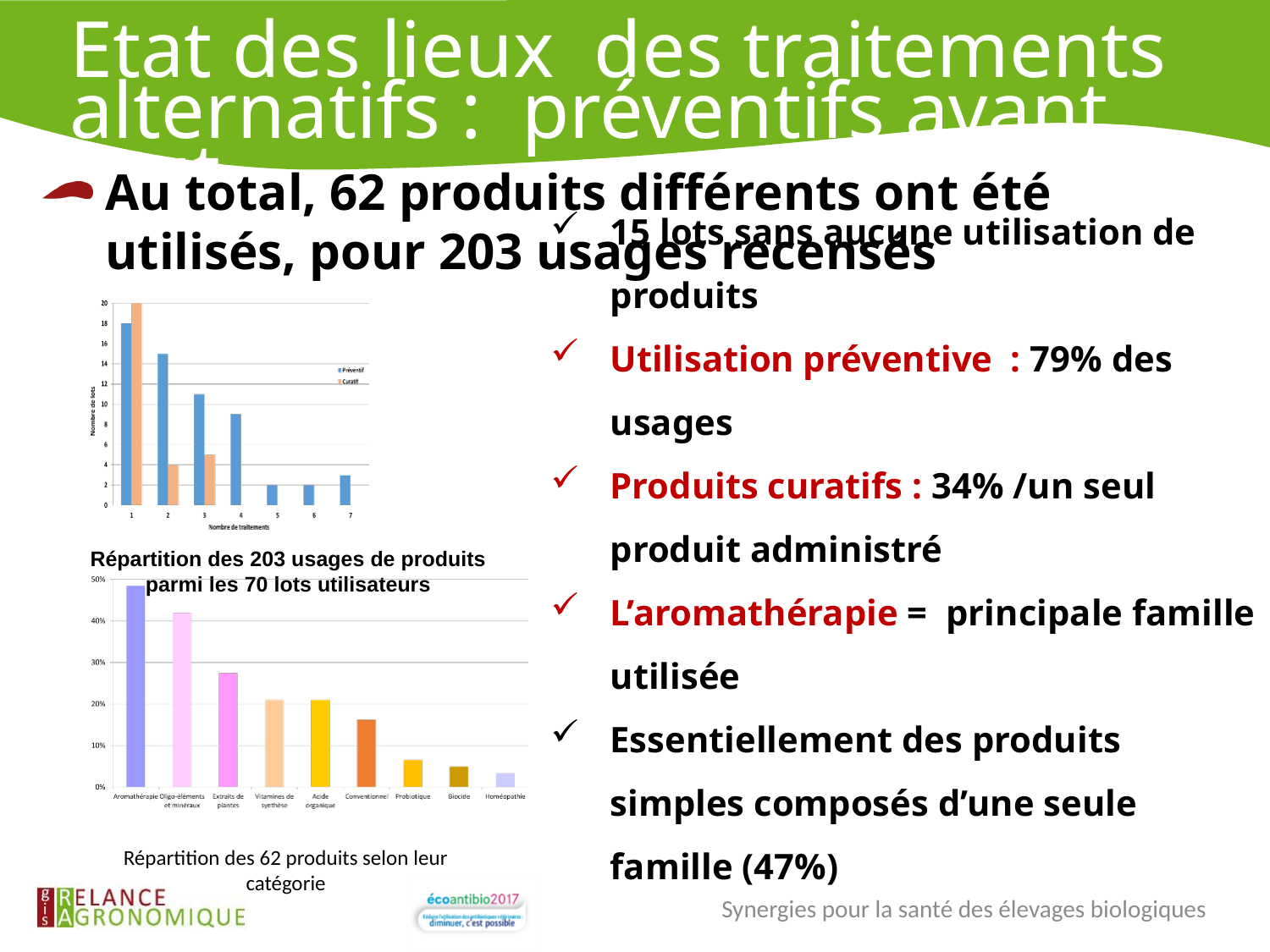
What are the two series named in the legend of the top chart? Préventif and Curatif In the top chart, is the Préventif value for 1 traitement greater or less than 16? greater In the top chart, for 1 traitement, which series has the larger value, Préventif or Curatif? Curatif What kind of chart is the top chart on the slide? bar chart In the top chart, is the Curatif value for 2 traitements greater or less than 6? less In the bottom chart (Répartition des 62 produits selon leur catégorie), which category has the highest value? Aromathérapie How many categories are shown in the bottom chart (Répartition des 62 produits selon leur catégorie)? 9 In the bottom chart, is the value for Conventionnel greater or less than 20%? less In the bottom chart (Répartition des 62 produits selon leur catégorie), which category has the lowest value? Homéopathie How many series does the legend of the top chart list? 2 In the top chart, do the Préventif values rise or fall from 1 to 4 traitements? fall How many values of 'Nombre de traitements' are shown on the x axis of the top chart? 7